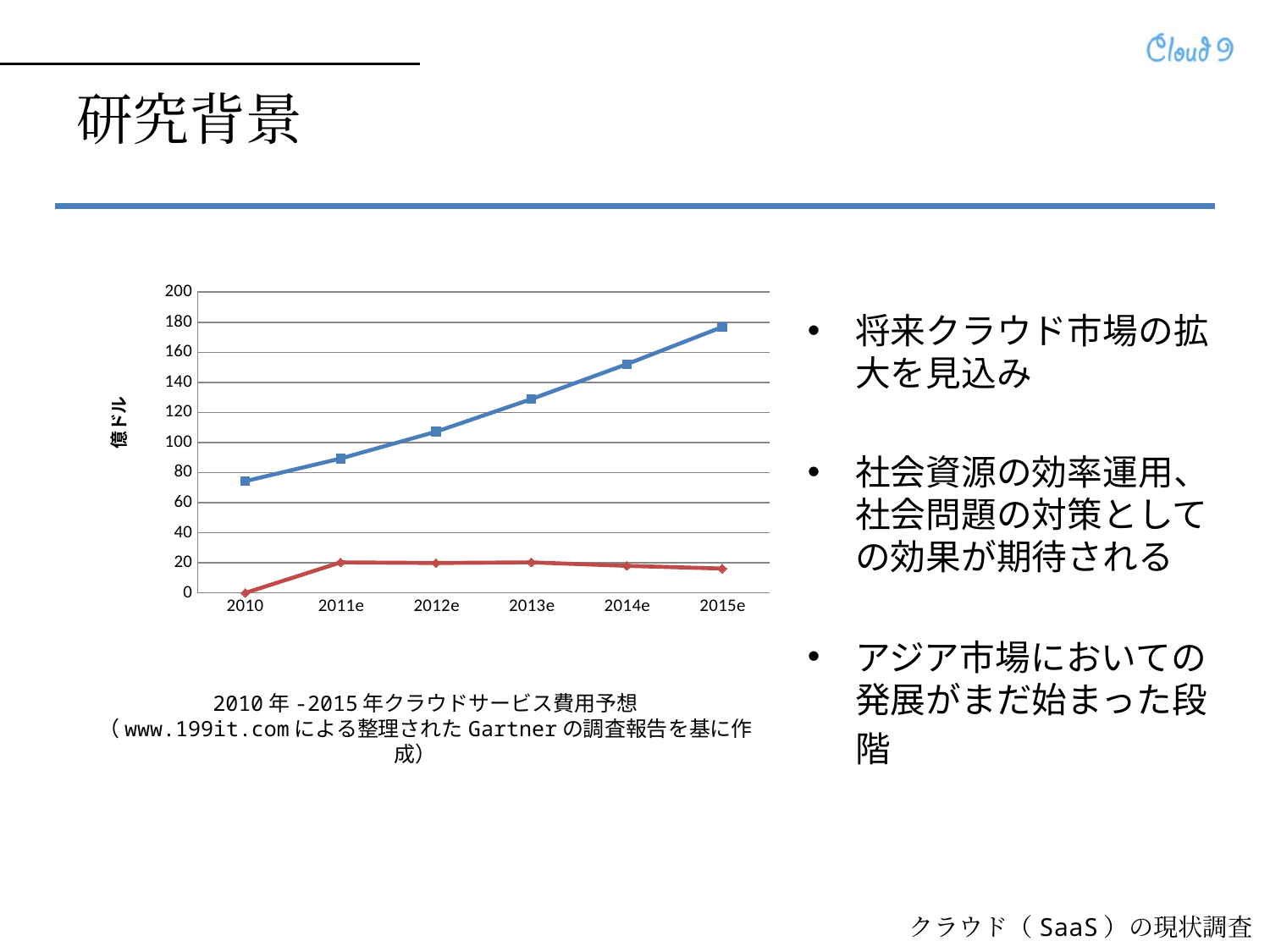
Is the value of the blue line for 2015e greater or less than 160? greater At which x-axis category does the blue line reach its highest value? 2015e What is the label on the y axis of the chart? 億ドル What kind of chart is shown on the slide? line chart Does the blue line rise or fall from 2010 to 2015e? rise Is the value of the red line for 2015e greater or less than 20? less How many points are plotted along the x axis of the chart? 6 What is the value of the red line at 2010? 0 At which x-axis category does the red line have its lowest value? 2010 Is the value of the blue line for 2010 greater or less than 80? less Which line has the larger value at 2014e, the blue line or the red line? blue line